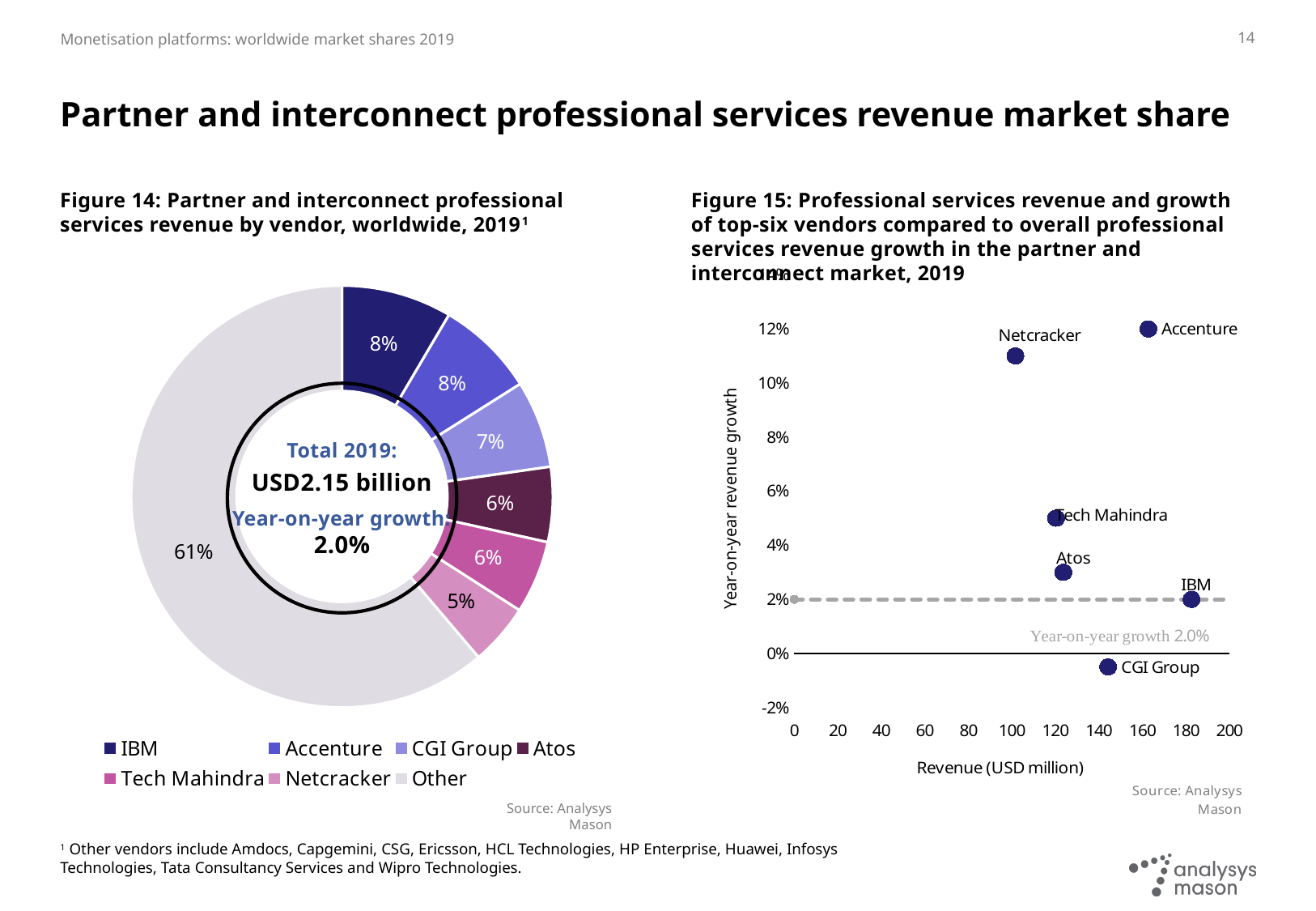
In Figure 15, what kind of chart is used? scatter chart In Figure 15, how many vendors are plotted? 6 In Figure 15, is the year-on-year revenue growth for CGI Group greater or less than 0%? less In Figure 14, how many percentage points larger is the Other share than the CGI Group share? 54 percentage points In Figure 15, is the year-on-year revenue growth for Accenture greater or less than 10%? greater In Figure 14, which named vendor (excluding Other) has the smallest share? Netcracker In Figure 14, what kind of chart is used to show partner and interconnect professional services revenue by vendor? doughnut chart In Figure 14, how many entries does the legend list? 7 In Figure 15, which vendor has the highest revenue (USD million)? IBM In Figure 14, what is the total 2019 revenue shown in the centre of the chart? USD2.15 billion In Figure 14, what share of revenue is attributed to Other vendors? 61% In Figure 14, what share of revenue does Netcracker hold? 5%